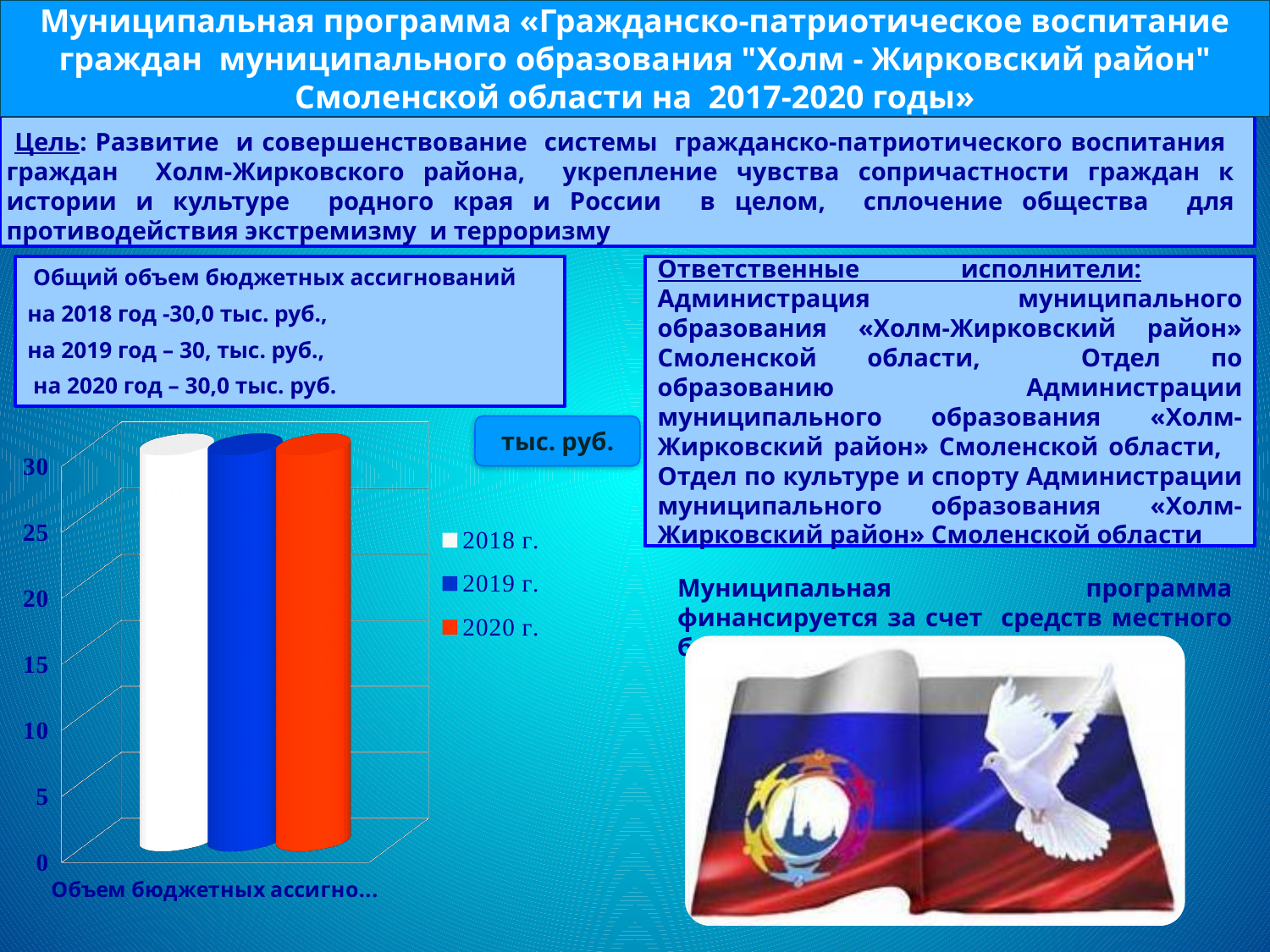
Is the value for 2019 г. greater or less than 25? greater What value does the bar for 2019 г. reach on the vertical axis? 30 What value does the bar for 2020 г. reach on the vertical axis? 30 Do the bar values rise, fall or stay the same from 2018 г. to 2020 г.? stay the same What kind of chart is shown on the slide? bar chart Is the value for 2020 г. greater or less than 20? greater Which colour represents the 2019 г. series in the chart legend? blue How many series does the chart legend list? 3 What is the highest tick value shown on the vertical axis of the chart? 30 What value does the bar for 2018 г. reach on the vertical axis? 30 How many bars are plotted in the chart? 3